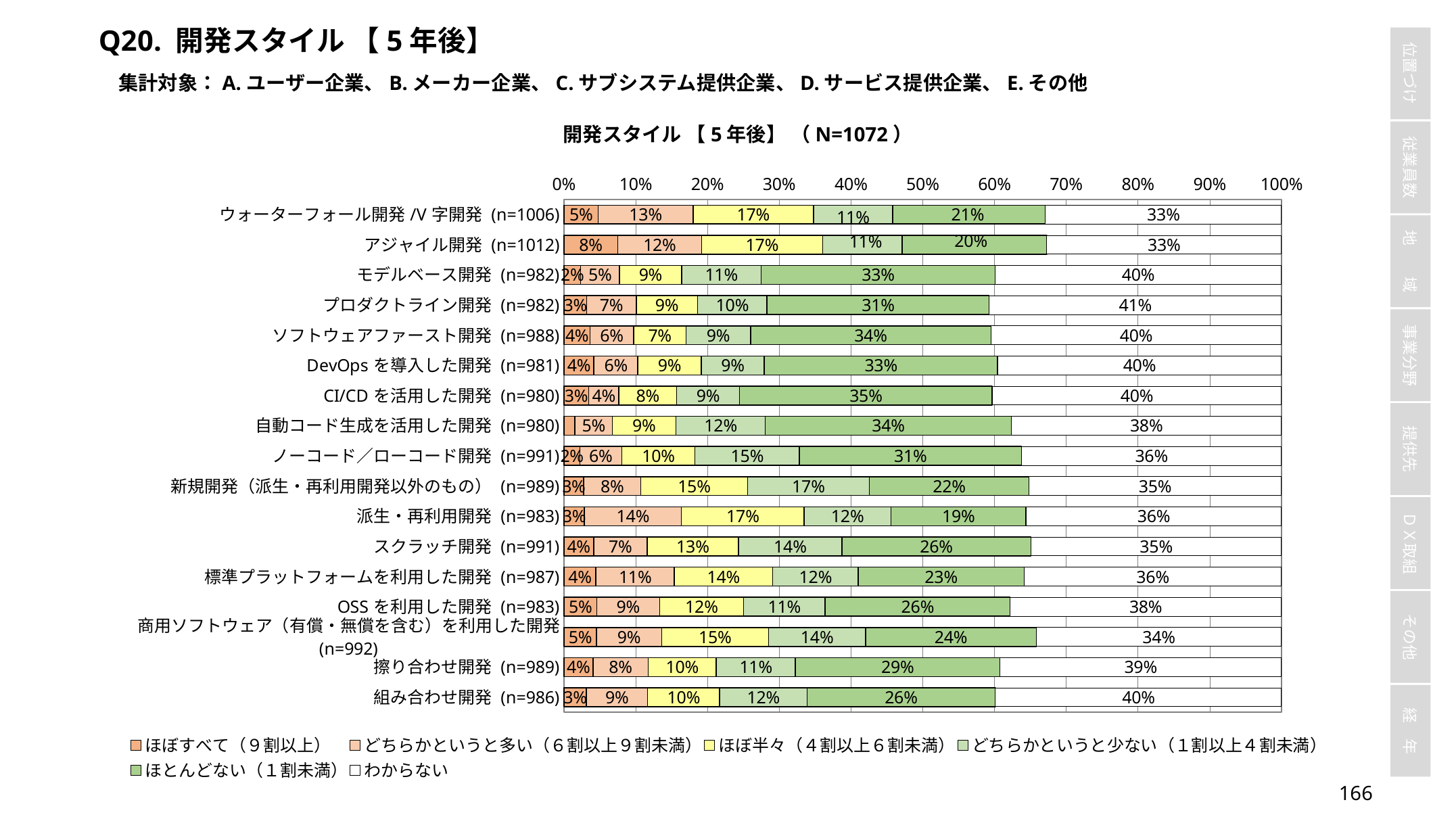
For ウォーターフォール開発/V字開発, what is the difference between ほぼ半々（４割以上６割未満） and ほぼすべて（９割以上）? 12 percentage points Which category has the highest value for わからない? プロダクトライン開発 How many development-style categories are plotted in the chart? 17 Which has the larger value for ほとんどない（１割未満）: スクラッチ開発 or 派生・再利用開発? スクラッチ開発 What is the value of わからない for プロダクトライン開発? 41% What is the value of ほとんどない（１割未満） for CI/CD を活用した開発? 35% What is the value of どちらかというと多い（６割以上９割未満） for 派生・再利用開発? 14% How many series does the legend list? 6 Which category has the highest value for ほとんどない（１割未満）? CI/CD を活用した開発 What is the value of ほぼすべて（９割以上） for アジャイル開発? 8% What is the N value shown in the chart title? N=1072 What kind of chart is shown on the slide? Stacked bar chart